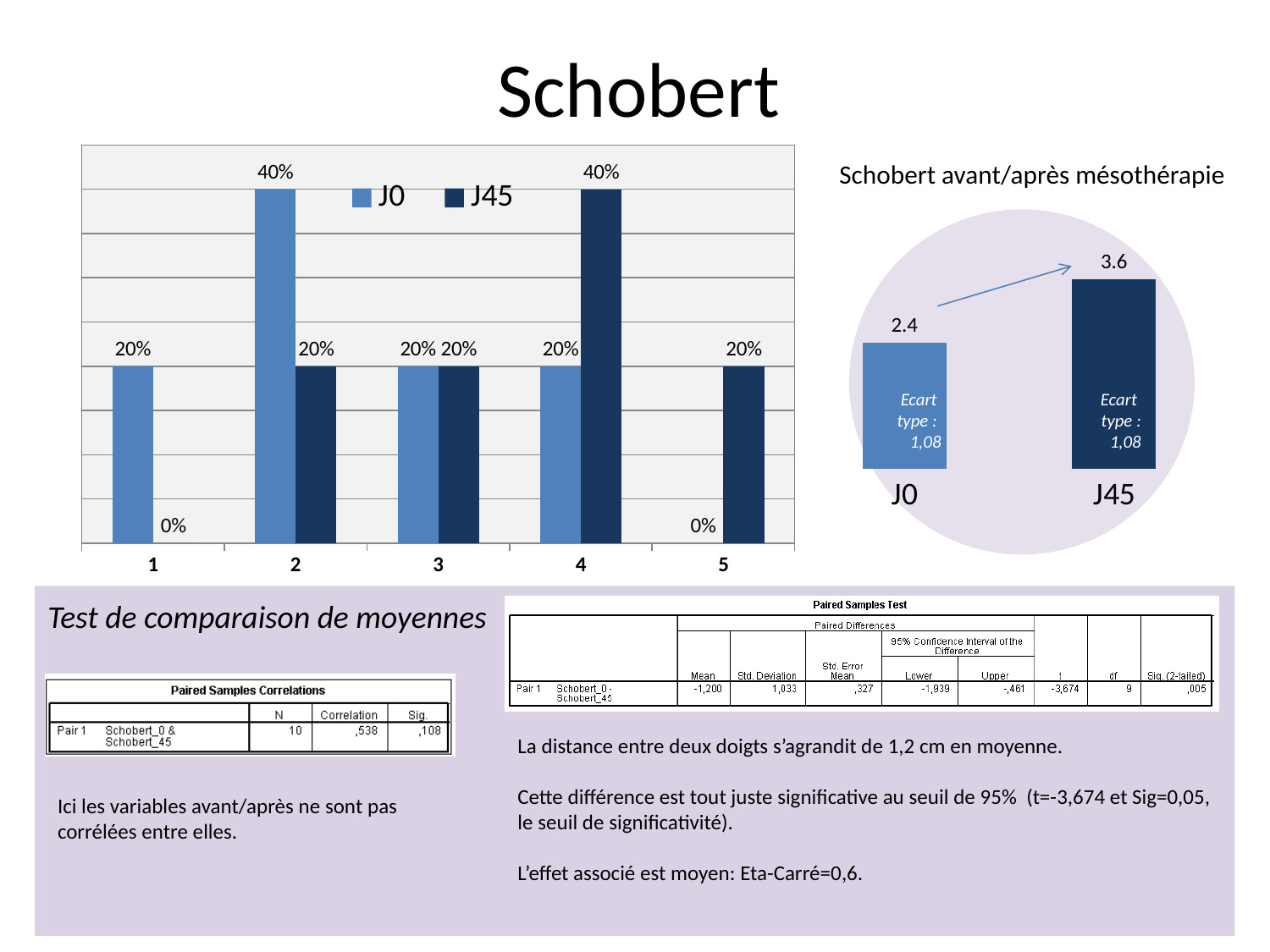
In the left bar chart, how many series does the legend list? 2 In the left bar chart, which category has the lowest J45 value? 1 In the left bar chart, what is the J0 value for category 5? 0% In the chart titled 'Schobert avant/après mésothérapie', what is the difference between the J45 and J0 values? 1.2 In the left bar chart, how many categories are shown on the x axis? 5 In the chart titled 'Schobert avant/après mésothérapie', what is the value for J45? 3.6 In the left bar chart, which category has the highest J0 value? 2 In the left bar chart, what is the J45 value for category 4? 40% In the left bar chart, what is the J0 value for category 2? 40% What kind of chart is the chart titled 'Schobert avant/après mésothérapie'? bar chart In the left bar chart, what is the difference between the J0 and J45 values for category 2? 20% In the left bar chart, what is the J45 value for category 1? 0%